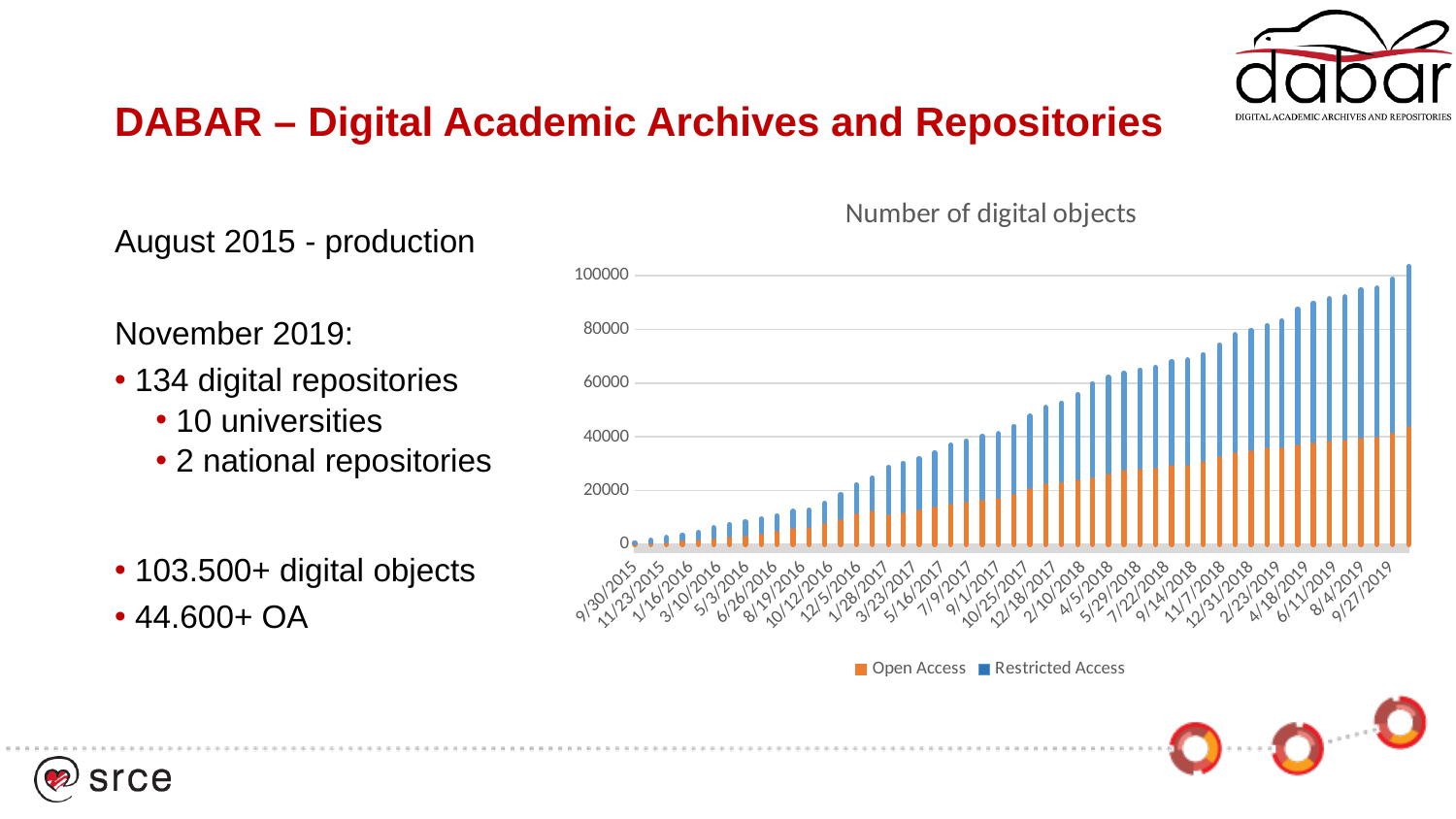
Which colour represents Open Access in the chart? Orange At 9/27/2019, which is larger: Open Access or Restricted Access? Restricted Access What kind of chart is shown on the slide? Stacked bar chart What is the title of the chart? Number of digital objects Which date has the lowest total number of digital objects? 9/30/2015 How many series does the chart legend list? 2 Is the total number of digital objects for 9/30/2015 greater or less than 20000? less Is the total number of digital objects for 1/28/2017 greater or less than 40000? less Is the Open Access value for 9/27/2019 greater or less than 40000? greater Do the total number of digital objects rise or fall from 9/30/2015 to 9/27/2019? Rise Which date has the highest total number of digital objects? 9/27/2019